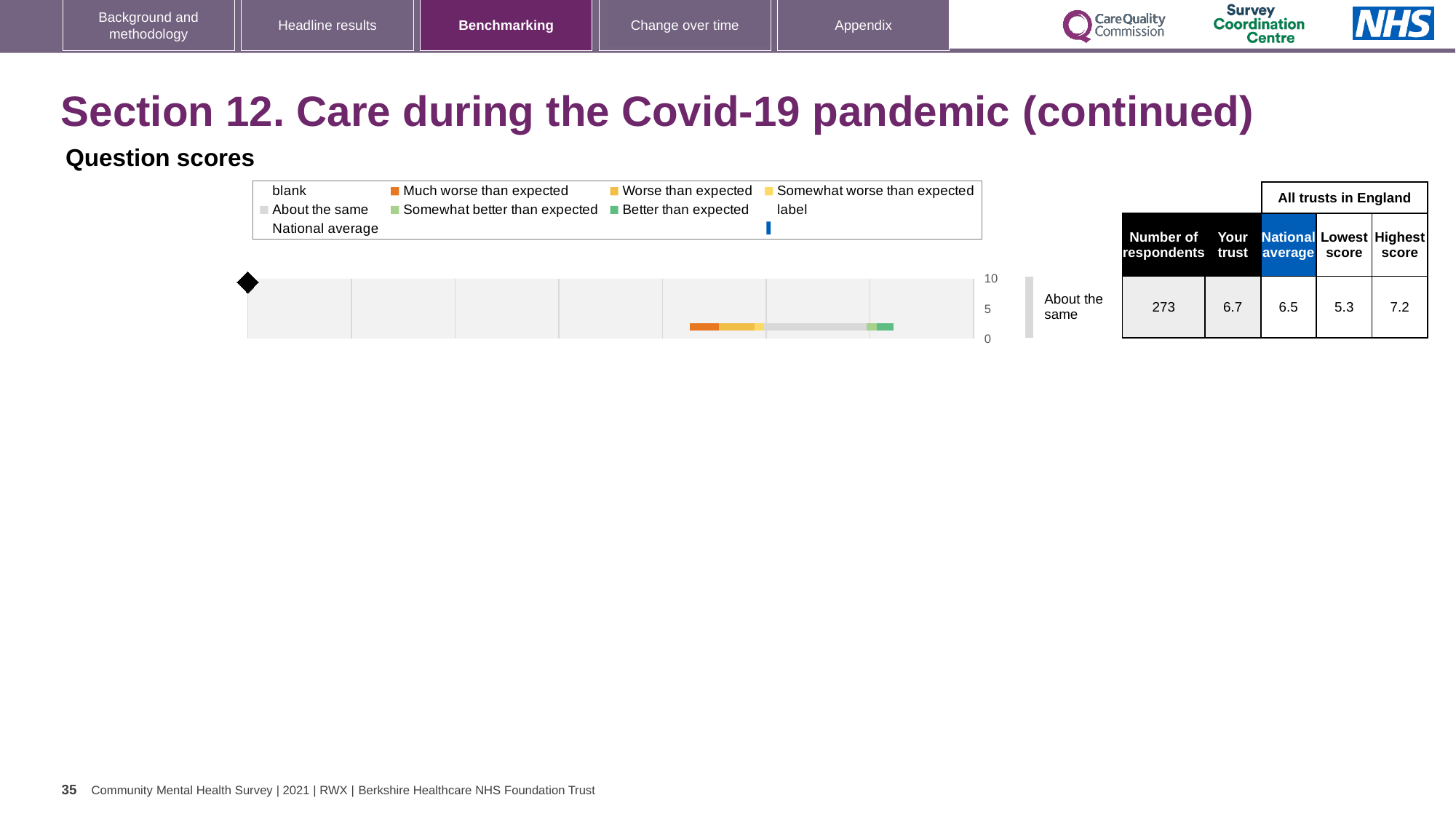
What is the national average score shown for the question on this slide? 6.5 What kind of chart is shown on the slide? bar chart What is the lowest score among all trusts in England shown on the slide? 5.3 What is the difference between the highest score and the lowest score among all trusts in England? 1.9 What benchmarking category is the trust's result labelled as next to the chart? About the same Which is larger, the 'Your trust' score or the national average score? Your trust What is the highest score among all trusts in England shown on the slide? 7.2 How many respondents are shown for the question on this slide? 273 What is the 'Your trust' score shown for the question on this slide? 6.7 What is the difference between the 'Your trust' score and the national average score? 0.2 Is the 'Your trust' score greater or less than 5? greater What is the maximum value shown on the chart's score axis? 10